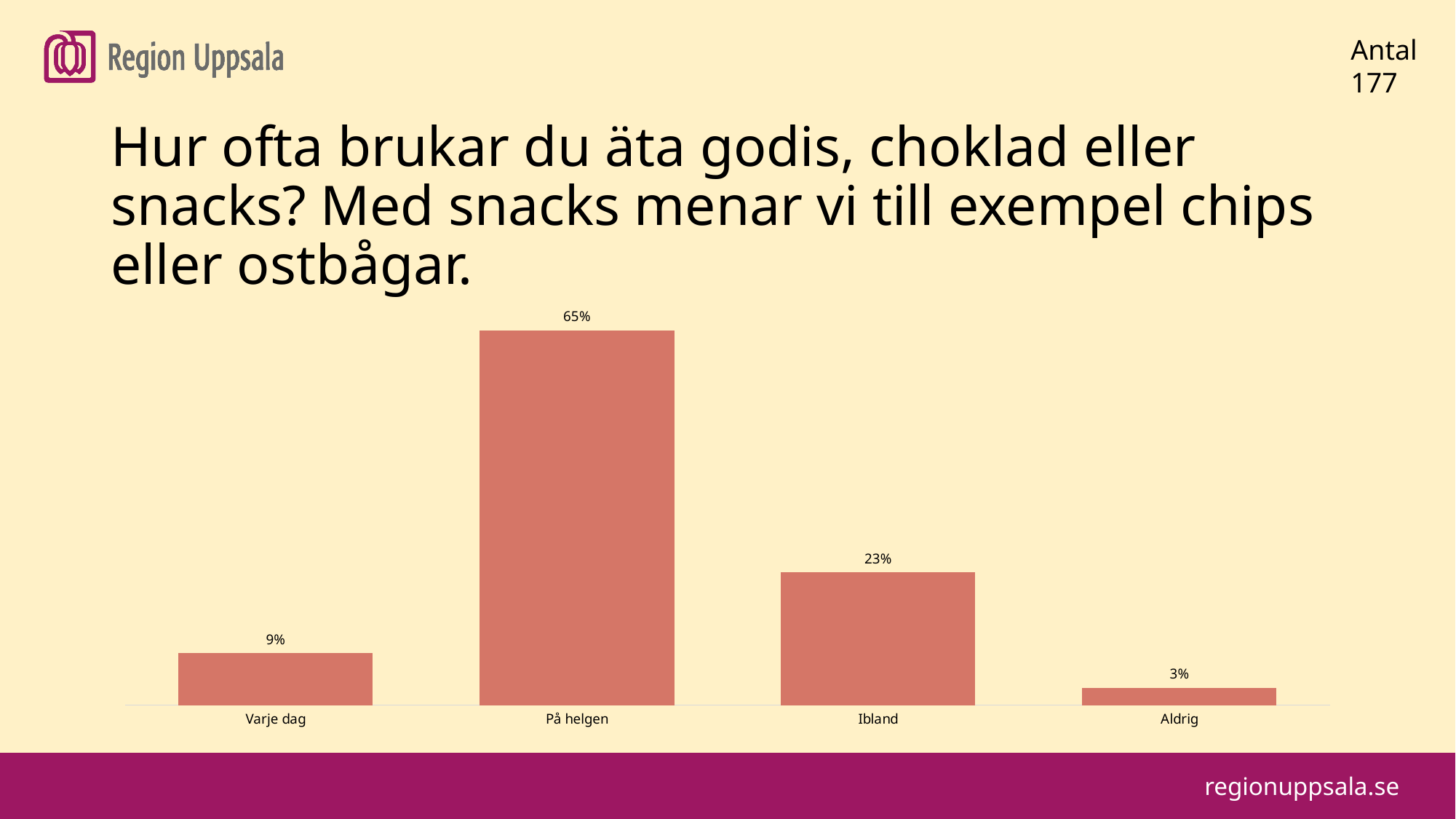
Which category has the lowest value? Aldrig What is the difference between the values for "På helgen" and "Ibland"? 42% What kind of chart is shown on the slide? Bar chart How many categories are shown in the chart? 4 What is the value for "Varje dag"? 9% What is the value for "På helgen"? 65% What is the difference between the values for "Varje dag" and "Aldrig"? 6% What is the value for "Ibland"? 23% Which is larger, the value for "Ibland" or the value for "Varje dag"? Ibland What is the value for "Aldrig"? 3% What number is shown next to "Antal" in the top right corner of the slide? 177 Which category has the highest value? På helgen